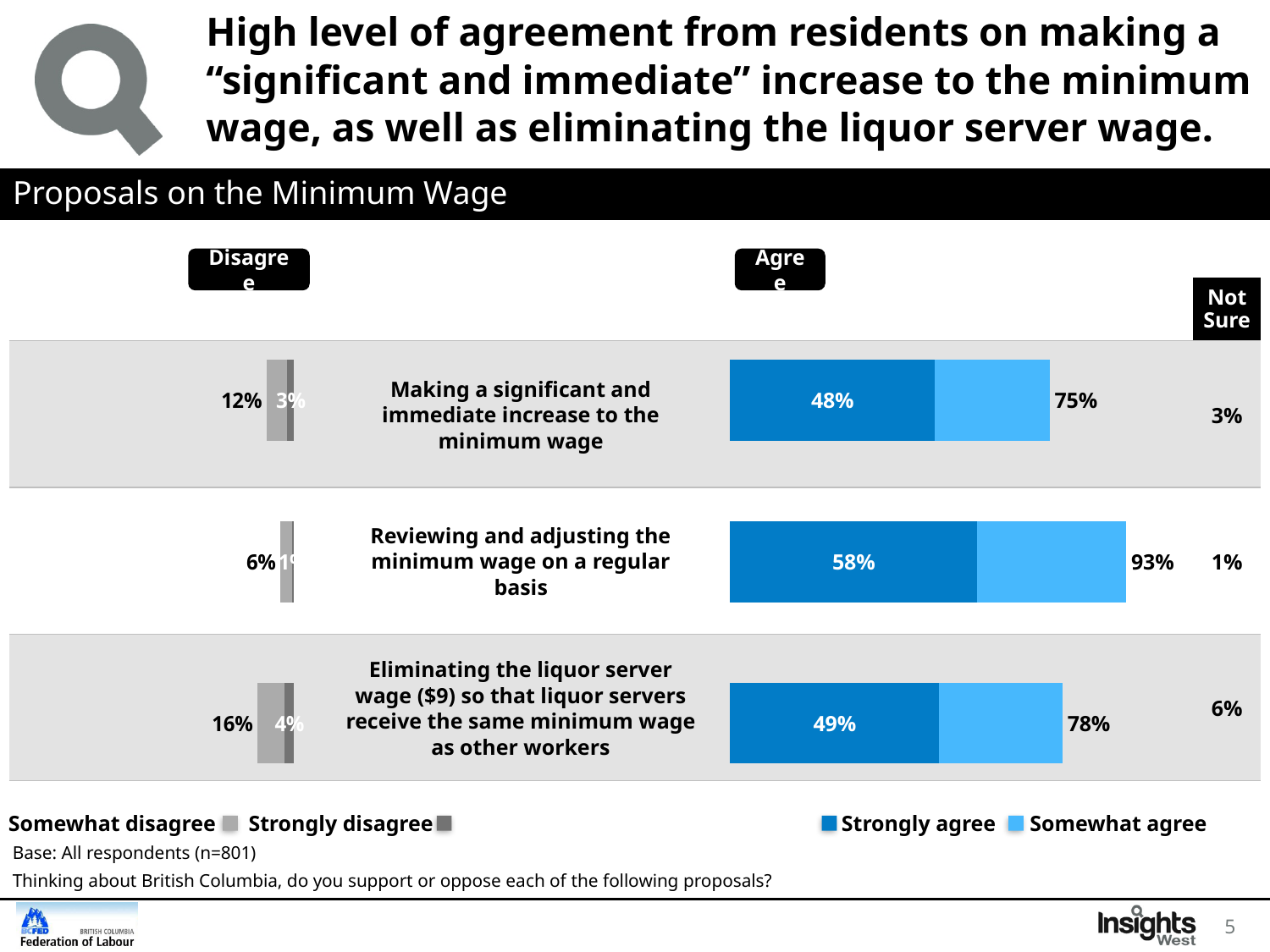
Which proposal has the highest total agree percentage? Reviewing and adjusting the minimum wage on a regular basis Which proposal has the lowest total agree percentage? Making a significant and immediate increase to the minimum wage What percentage strongly agree with reviewing and adjusting the minimum wage on a regular basis? 58% What is the difference between the total agree percentages for reviewing the minimum wage regularly (93%) and eliminating the liquor server wage (78%)? 15% How many proposals are shown in the chart? 3 What is the title of the chart? Proposals on the Minimum Wage Which has a higher strongly agree percentage: making a significant and immediate increase to the minimum wage, or eliminating the liquor server wage? Eliminating the liquor server wage How many series does the legend list in total? 4 What kind of chart is shown on the slide? Bar chart What is the total agree percentage for making a significant and immediate increase to the minimum wage? 75% What percentage are not sure about eliminating the liquor server wage? 6% What percentage strongly agree with eliminating the liquor server wage ($9)? 49%